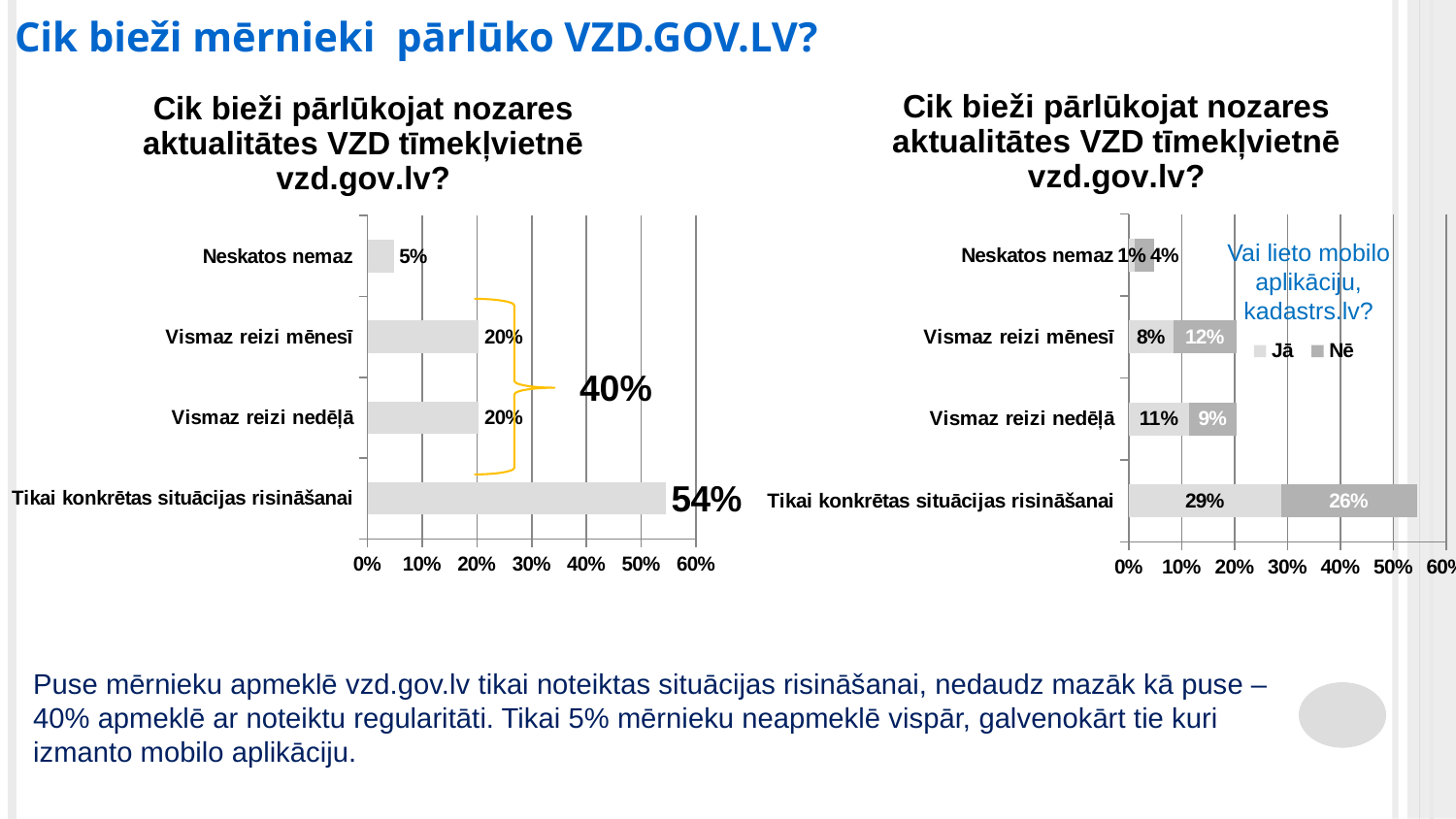
In the left chart, what is the value for 'Neskatos nemaz'? 5% In the right chart, what is the 'Jā' value for 'Tikai konkrētas situācijas risināšanai'? 29% In the right chart, how many series does the legend list? 2 In the right chart, for 'Neskatos nemaz', which is larger: 'Jā' or 'Nē'? Nē In the right chart, what is the total of the stacked bar for 'Vismaz reizi nedēļā'? 20% In the left chart, which category has the highest value? Tikai konkrētas situācijas risināšanai In the left chart, what is the difference between 'Tikai konkrētas situācijas risināšanai' and 'Vismaz reizi nedēļā'? 34% In the right chart, what is the 'Nē' value for 'Vismaz reizi mēnesī'? 12% In the left chart, how many categories are shown? 4 In the left chart, what is the value for 'Tikai konkrētas situācijas risināšanai'? 54% What type of chart is the left chart? Bar chart In the left chart, which category has the lowest value? Neskatos nemaz